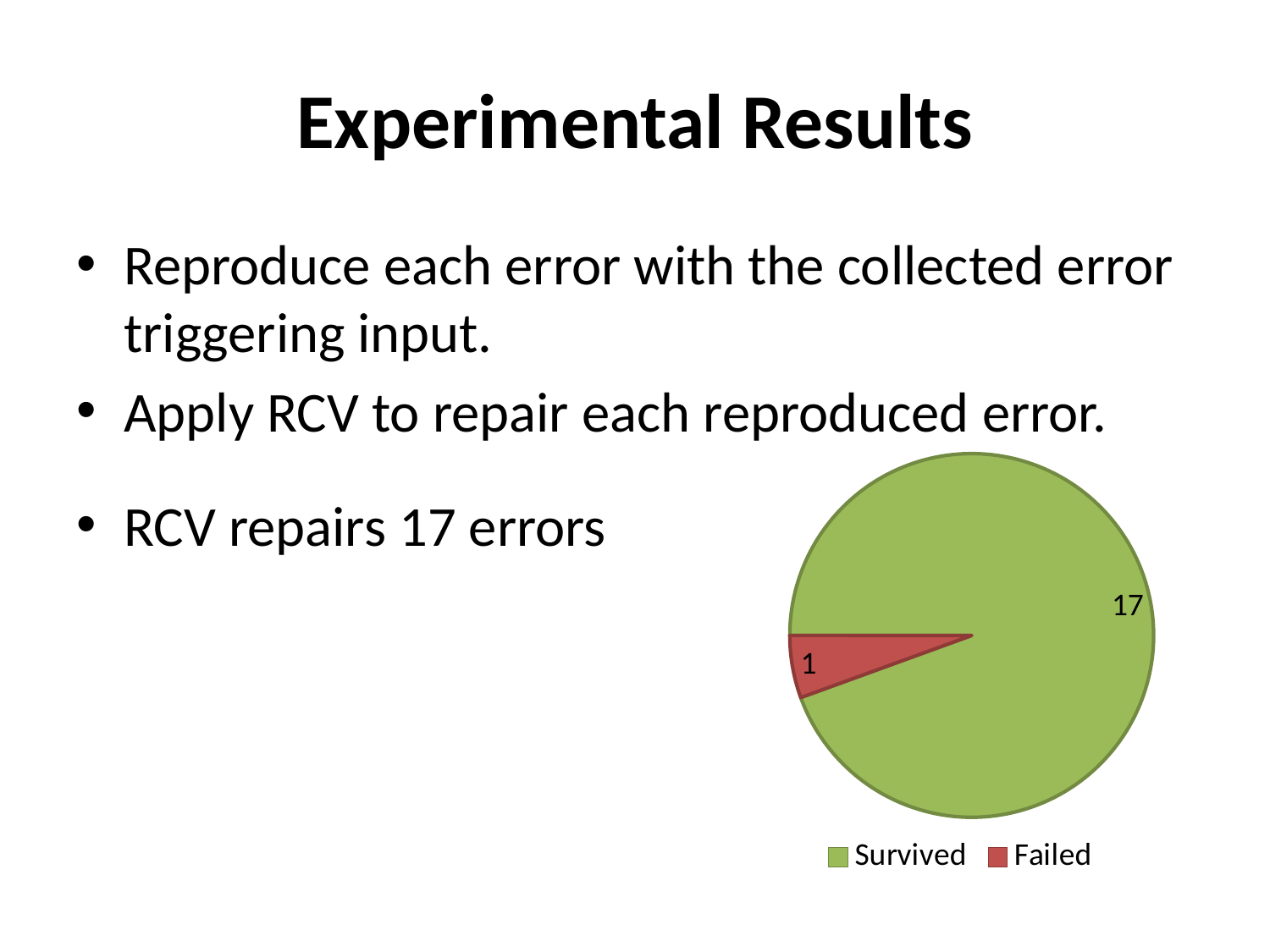
Which category has the smallest slice in the pie chart? Failed What kind of chart is shown on the slide? pie chart What is the value for Failed in the pie chart? 1 Which is larger in the pie chart, Survived or Failed? Survived Which category has the largest slice in the pie chart? Survived What is the value for Survived in the pie chart? 17 How many entries does the legend of the pie chart list? 2 What colour is the Failed slice in the pie chart? red What colour is the Survived slice in the pie chart? green What is the difference between the Survived and Failed values in the pie chart? 16 How many categories does the pie chart have? 2 What is the total of all slices in the pie chart? 18